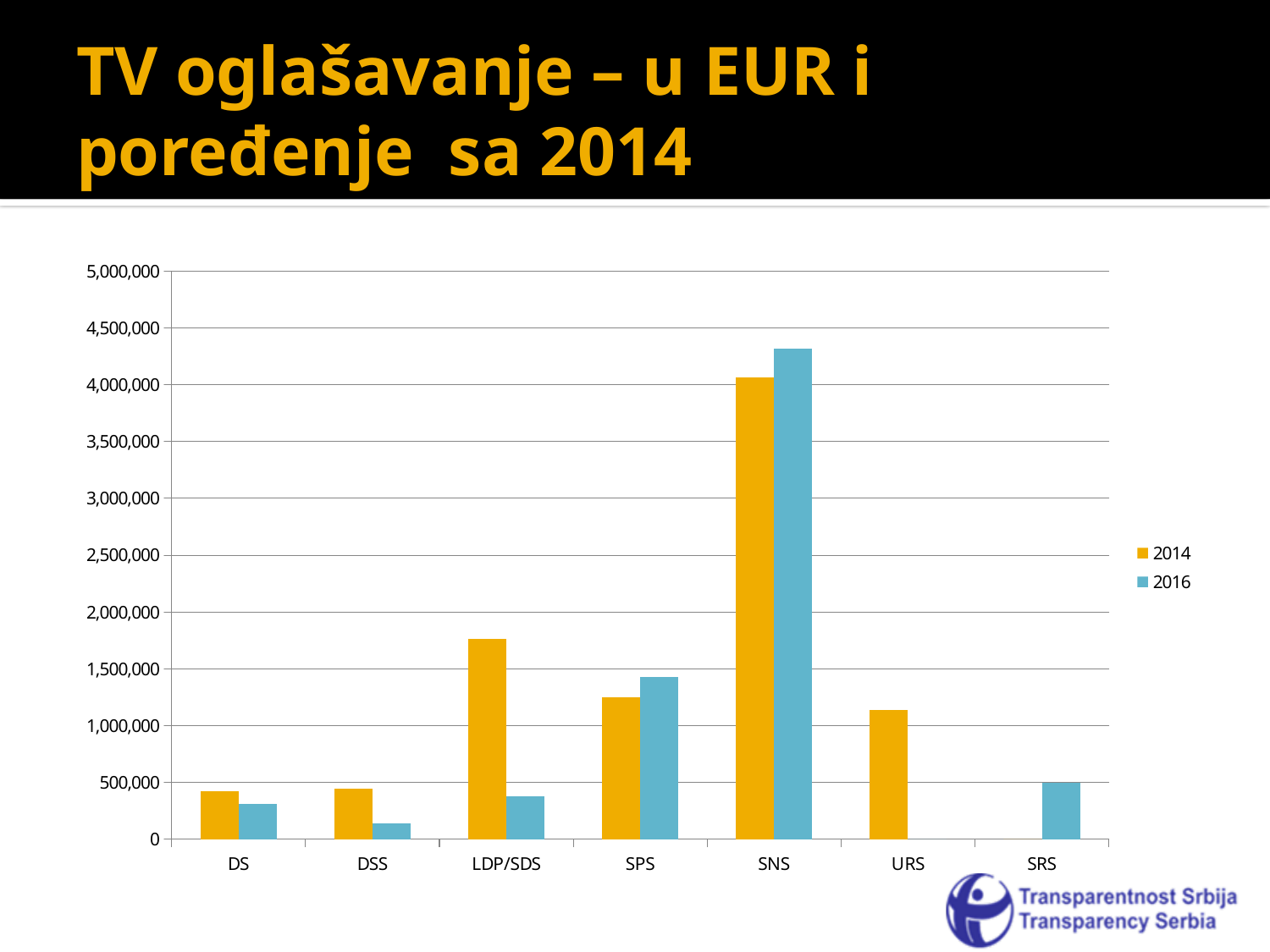
Which party has the highest 2014 value in the chart? SNS What are the two entries listed in the chart legend? 2014 and 2016 Is the 2014 value for LDP/SDS greater or less than 1,500,000? greater Which party has the highest 2016 value in the chart? SNS What kind of chart is shown on the slide? Bar chart Is the 2014 value for URS greater or less than 1,000,000? greater How many series does the chart legend list? 2 Is the 2016 value for SNS greater or less than 4,000,000? greater For LDP/SDS, which year has the larger value, 2014 or 2016? 2014 For SPS, which year has the larger value, 2014 or 2016? 2016 How many parties (categories) are shown on the x axis of the chart? 7